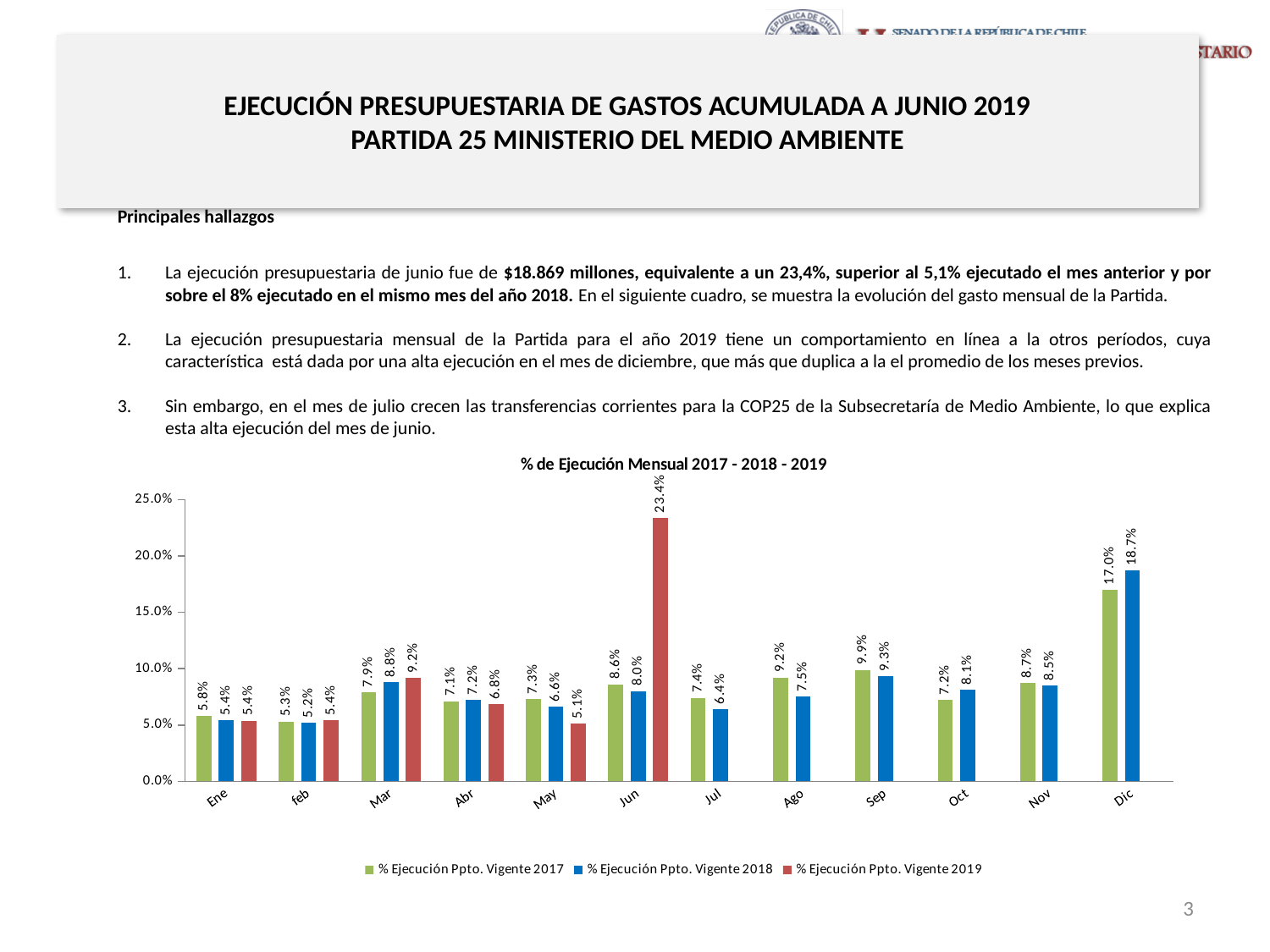
What is the value for % Ejecución Ppto. Vigente 2019 in Jun? 23.4% What is the difference between the 2018 and 2017 values in Dic? 1.7% Is the value for % Ejecución Ppto. Vigente 2019 in Jun greater or less than 20.0%? greater How many months are shown on the x axis? 12 What is the title of the chart? % de Ejecución Mensual 2017 - 2018 - 2019 Which month has the highest value for % Ejecución Ppto. Vigente 2017? Dic How many series does the legend list? 3 In Mar, which series has the larger value: % Ejecución Ppto. Vigente 2017 or % Ejecución Ppto. Vigente 2019? % Ejecución Ppto. Vigente 2019 Which month has the lowest value for % Ejecución Ppto. Vigente 2019? May What is the value for % Ejecución Ppto. Vigente 2017 in Sep? 9.9% What is the value for % Ejecución Ppto. Vigente 2018 in Dic? 18.7% What kind of chart is shown on the slide? Bar chart